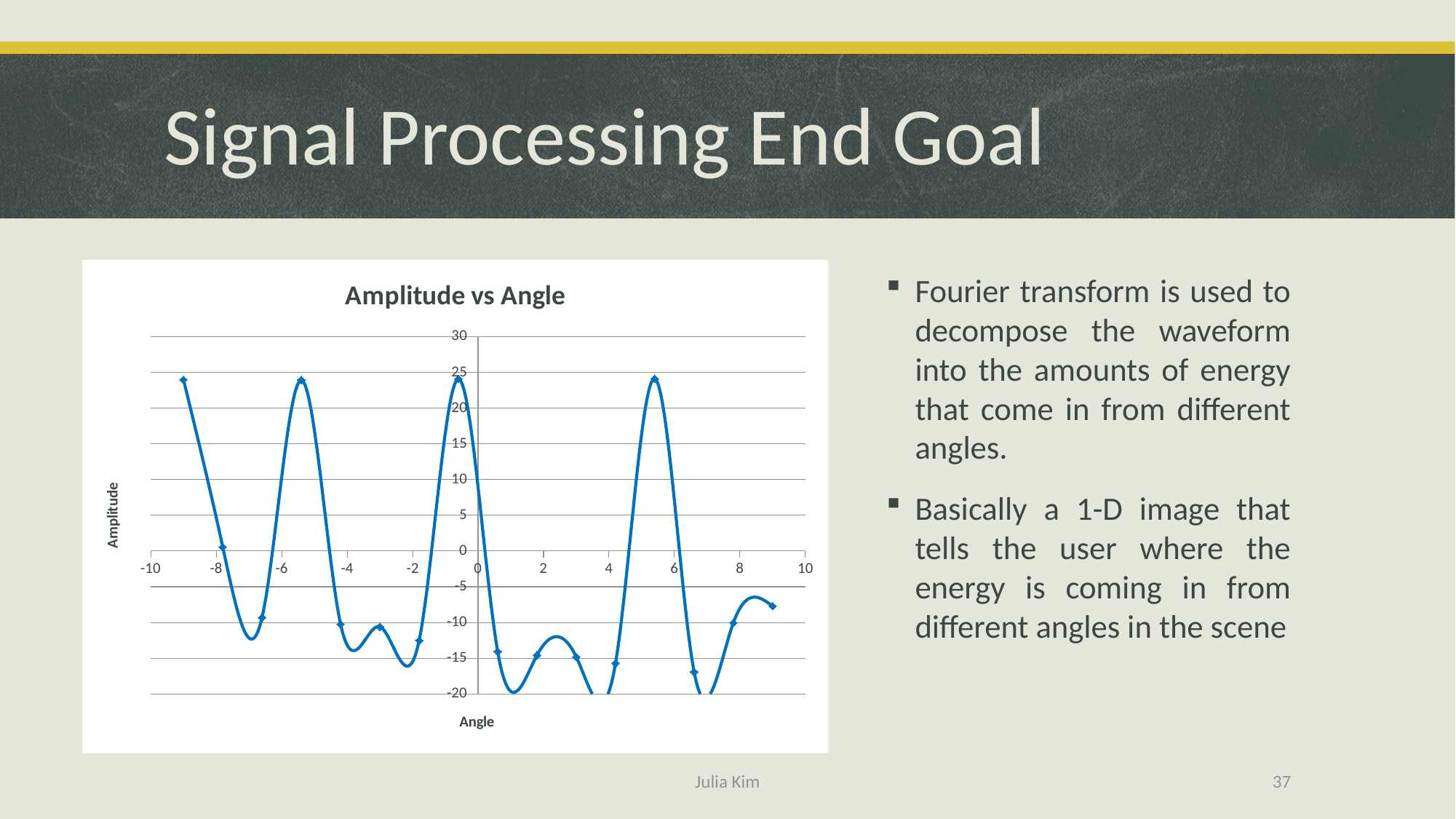
Which is larger, the value at angle -7 or the value at angle -9? angle -9 Which is larger, the value at angle 0 or the value at angle 2? angle 0 What is the title of the chart? Amplitude vs Angle Is the value for angle 4 greater or less than -10? less Is the value for angle -3 greater or less than -5? less Is the value for angle -7 greater or less than -5? less What is the label of the vertical axis of the chart? Amplitude What kind of chart is shown on the slide? line chart